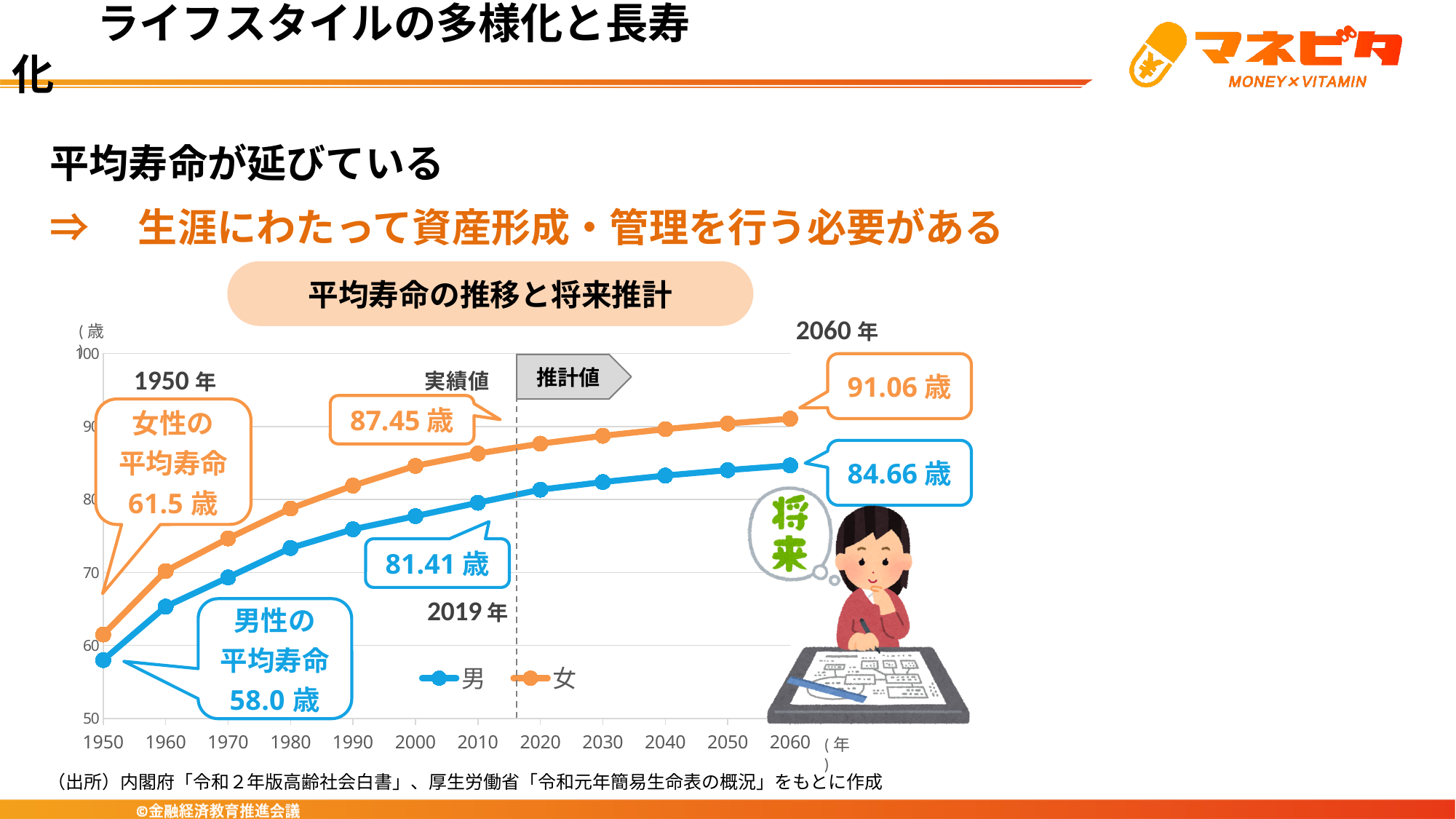
What is the male (男) average life expectancy shown for 1950? 58.0歳 What is the title of the chart? 平均寿命の推移と将来推計 Which series has the higher value in 2019, 男 or 女? 女 Do the values for 女 rise or fall from 1950 to 2060? rise What is the difference between the female and male life expectancy values shown for 2060? 6.40歳 What is the male (男) average life expectancy projected for 2060? 84.66歳 How many series does the chart legend list? 2 What is the difference between the female and male life expectancy values shown for 1950? 3.5歳 What is the female (女) average life expectancy shown for 1950? 61.5歳 Is the value for 男 in 1960 greater or less than 70? less What kind of chart is shown on the slide? Line chart What is the female (女) average life expectancy shown for 2019? 87.45歳